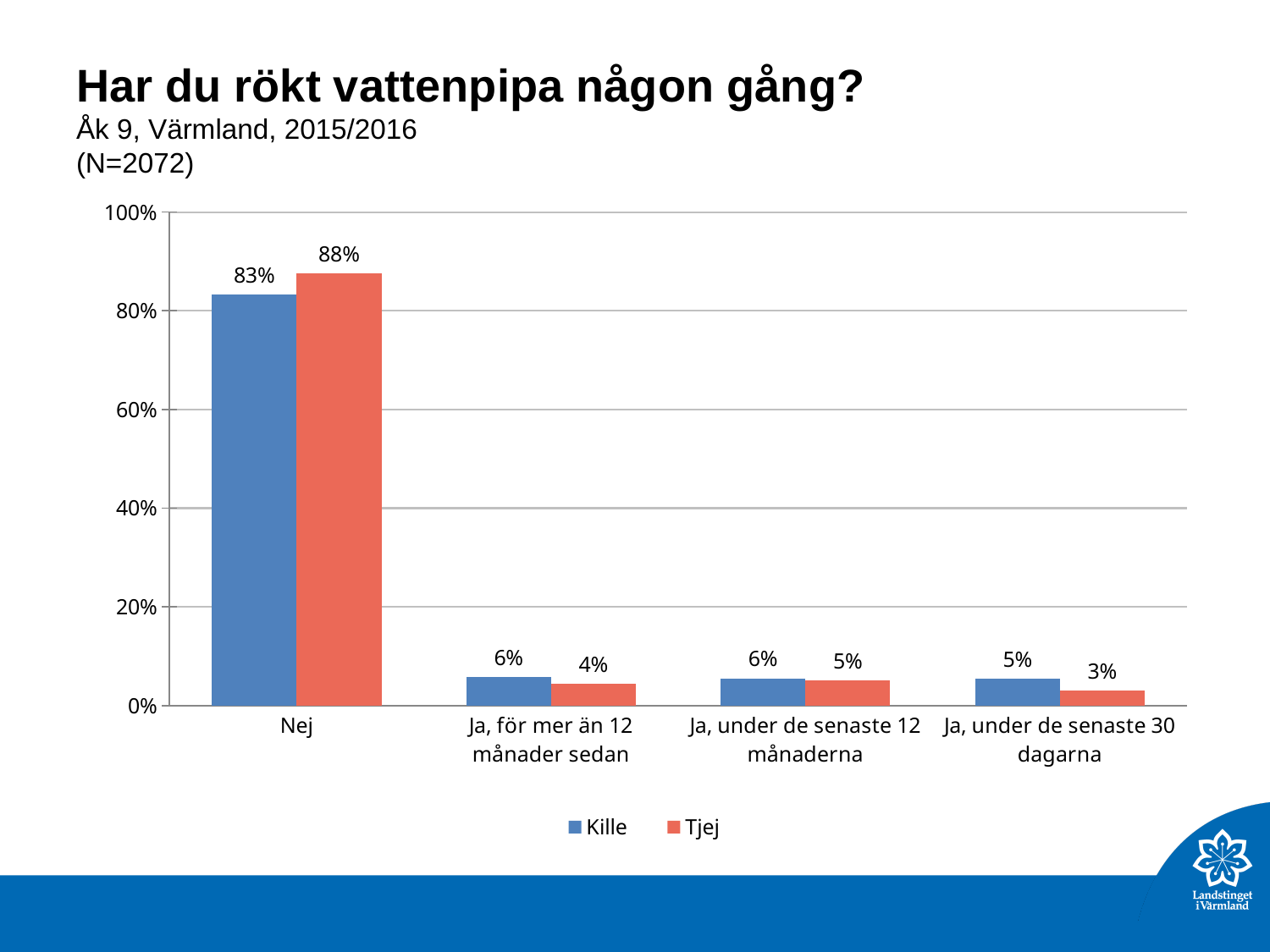
What kind of chart is shown on the slide? Bar chart How many categories are shown on the x axis? 4 How many series does the legend list? 2 What is the value for Tjej in the "Nej" category? 88% What is the value for Tjej in the "Ja, under de senaste 30 dagarna" category? 3% Is the value for Kille in the "Nej" category greater or less than 80%? greater Which category has the lowest value for Tjej? Ja, under de senaste 30 dagarna Which category has the highest value for Tjej? Nej In the "Ja, för mer än 12 månader sedan" category, which series has the larger value, Kille or Tjej? Kille What is the value for Kille in the "Ja, under de senaste 12 månaderna" category? 6% What is the difference between the Tjej and Kille values in the "Nej" category? 5% What is the value for Kille in the "Nej" category? 83%